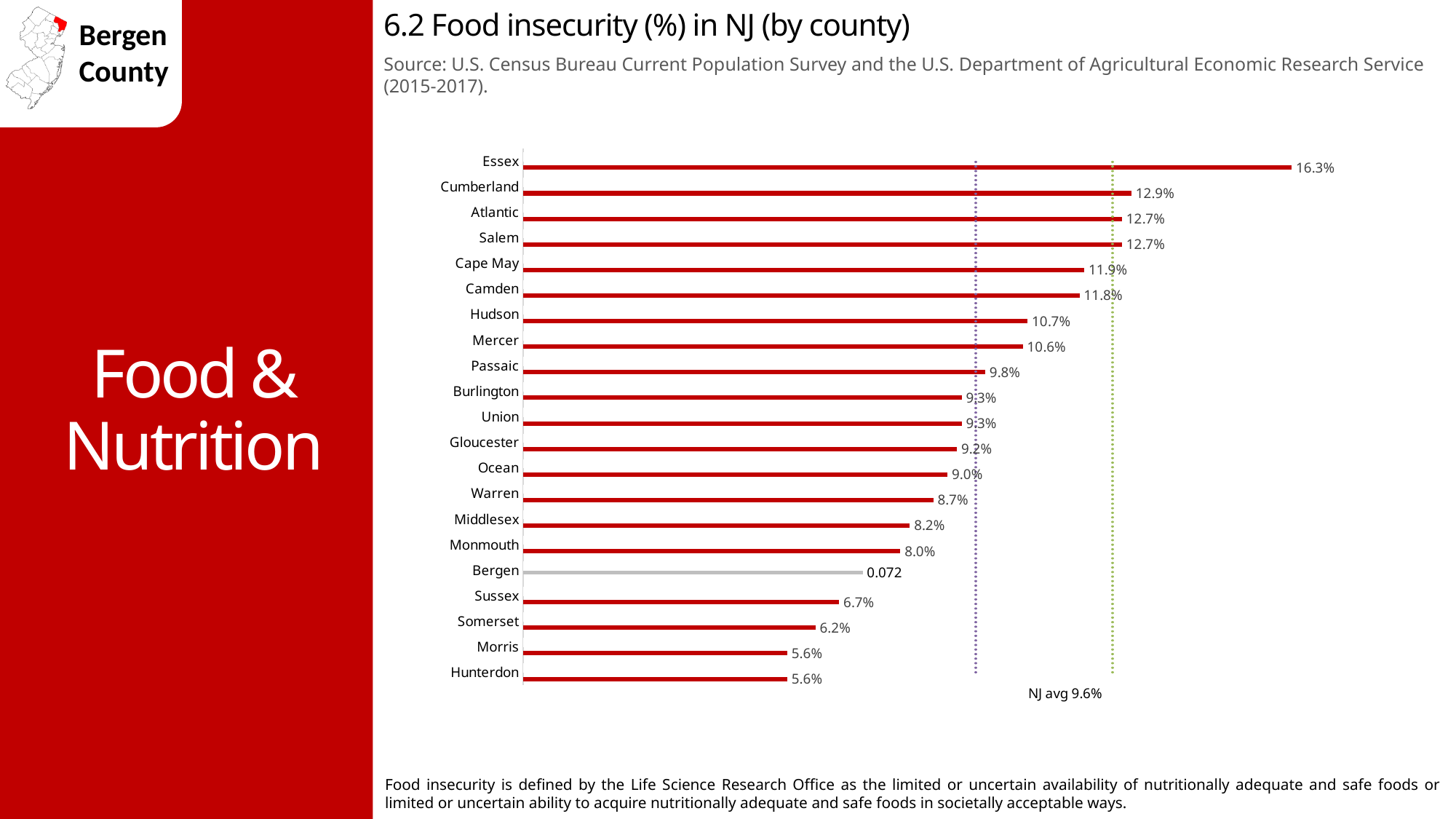
What is the difference in percentage points between Essex (16.3%) and Cumberland (12.9%)? 3.4 What is the difference in percentage points between Middlesex (8.2%) and Monmouth (8.0%)? 0.2 What is the food insecurity value for Somerset county? 6.2% What is the food insecurity value for Hudson county? 10.7% Which has a higher food insecurity value, Passaic or Burlington? Passaic Which has a higher food insecurity value, Camden or Mercer? Camden How many counties are listed on the chart? 21 What is the food insecurity value shown for Essex county? 16.3% What value is printed next to the Bergen bar? 0.072 What kind of chart is used to show food insecurity by county? Bar chart Which county has the highest food insecurity percentage? Essex What NJ average value is noted on the chart? NJ avg 9.6%